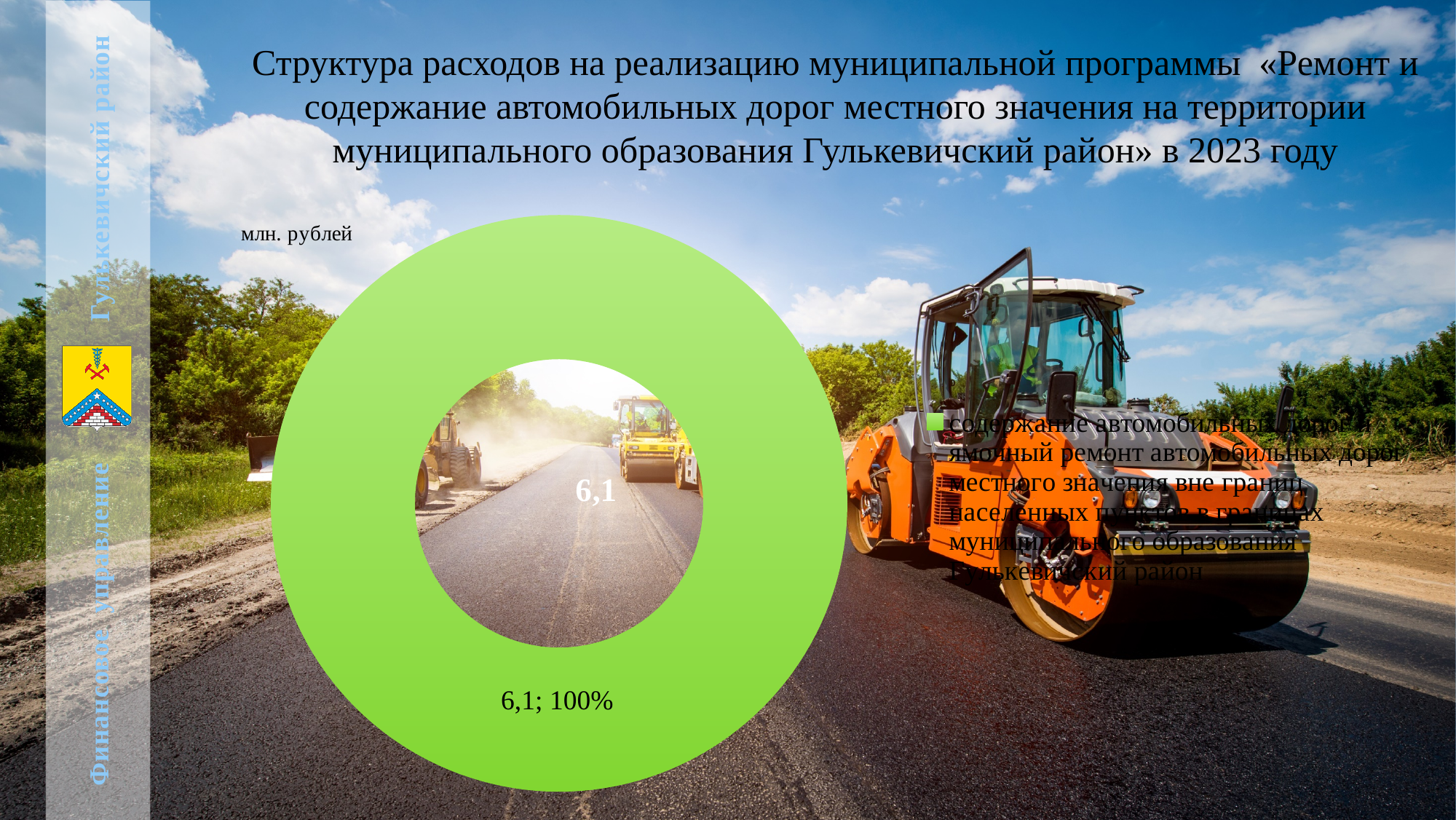
What value is shown for the slice "содержание автомобильных дорог и ямочный ремонт автомобильных дорог местного значения вне границ населенных пунктов в границах муниципального образования Гулькевичский район"? 6,1 What year does the chart title say the expenditure structure refers to? 2023 Is the value shown in the doughnut chart greater or less than 10? less How many slices does the doughnut chart contain? 1 In what units are the chart values expressed, according to the label above the chart? млн. рублей Is the value shown in the doughnut chart greater or less than 5? greater What share of the doughnut does the single slice represent? 100% What kind of chart is shown on the slide? Doughnut (pie) chart What colour is the slice in the doughnut chart? Green What is the total value of all slices in the doughnut chart? 6,1 How many entries does the chart legend list? 1